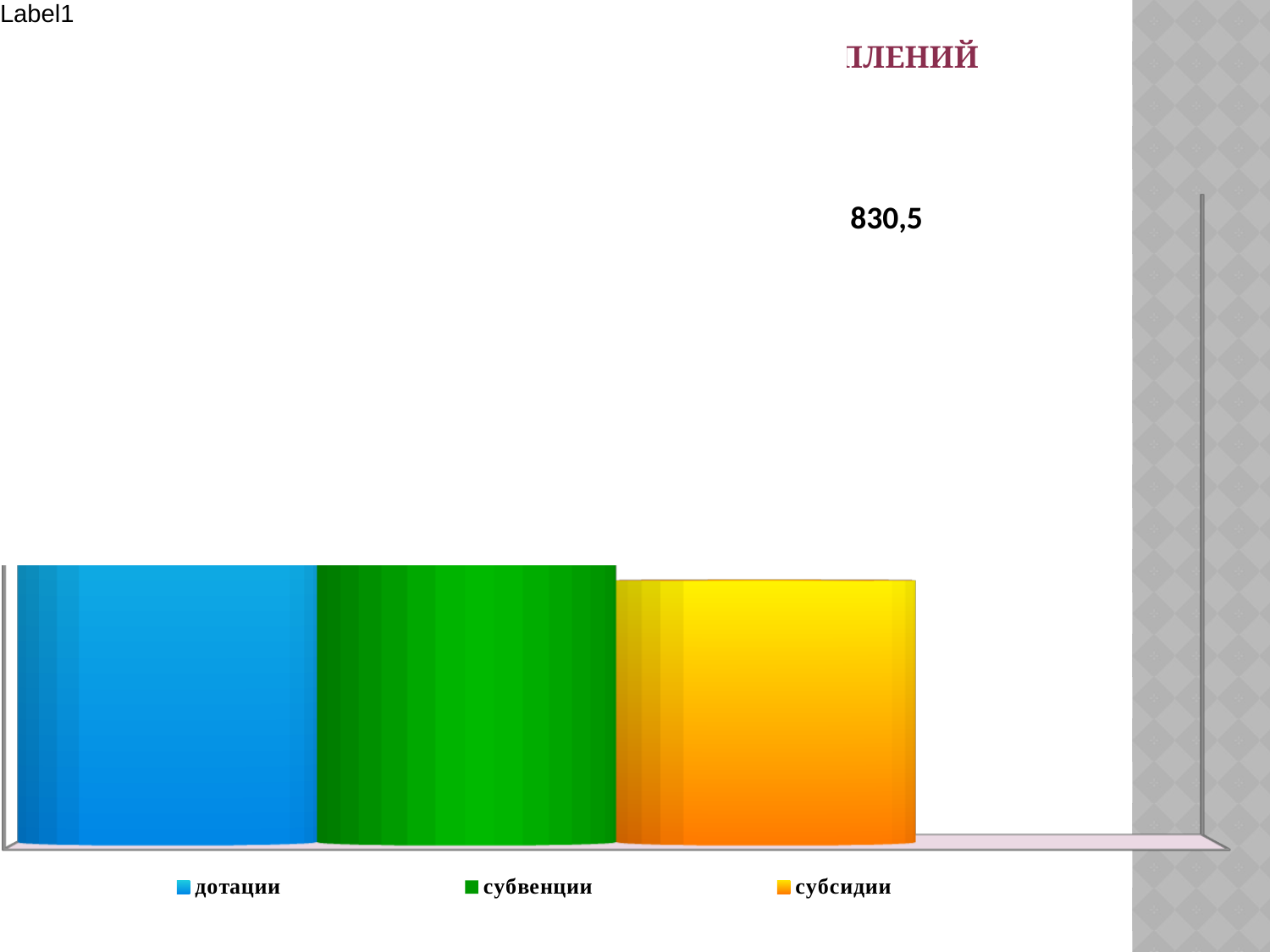
Which series has the lowest bar in the chart? субсидии What kind of chart is shown on the slide? bar chart How many series does the legend list? 3 What are the legend entries of the chart, from left to right? дотации, субвенции, субсидии How many bars are plotted in the chart? 3 Which colour represents субвенции in the chart? green Which is larger, the bar for дотации or the bar for субсидии? дотации